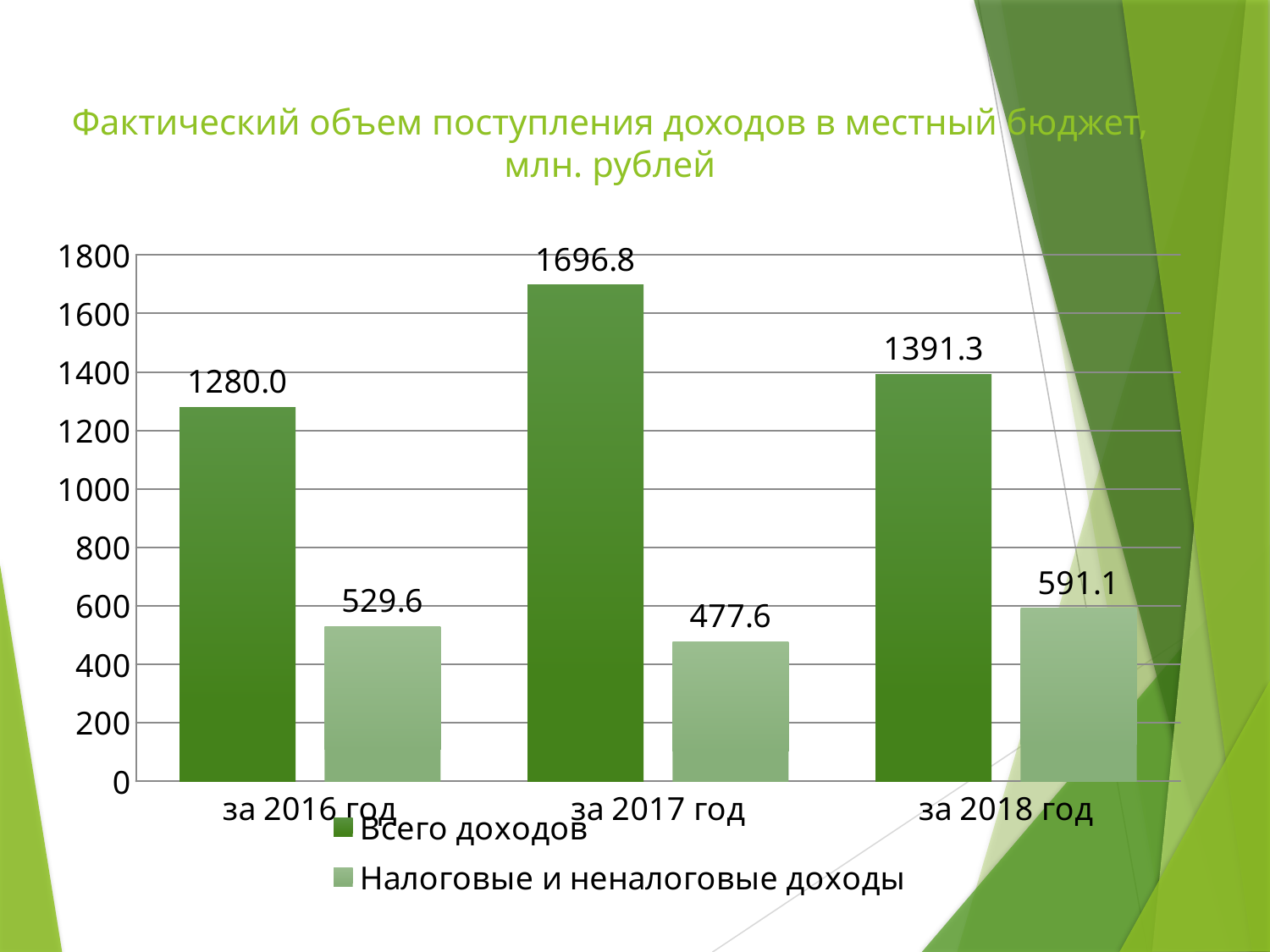
How many years are shown on the x axis? 3 Which year has the lowest value for "Налоговые и неналоговые доходы"? за 2017 год Is the value of "Всего доходов" for "за 2016 год" greater or less than 1400? less What is the value of "Всего доходов" for "за 2018 год"? 1391.3 Which is larger: "Налоговые и неналоговые доходы" for "за 2018 год" or for "за 2016 год"? за 2018 год What kind of chart is shown on the slide? bar chart What is the value of "Всего доходов" for "за 2017 год"? 1696.8 Which year has the highest value for "Всего доходов"? за 2017 год What is the difference between "Всего доходов" for "за 2017 год" and "за 2016 год"? 416.8 What is the title of the chart? Фактический объем поступления доходов в местный бюджет, млн. рублей How many series does the legend list? 2 What is the value of "Налоговые и неналоговые доходы" for "за 2016 год"? 529.6